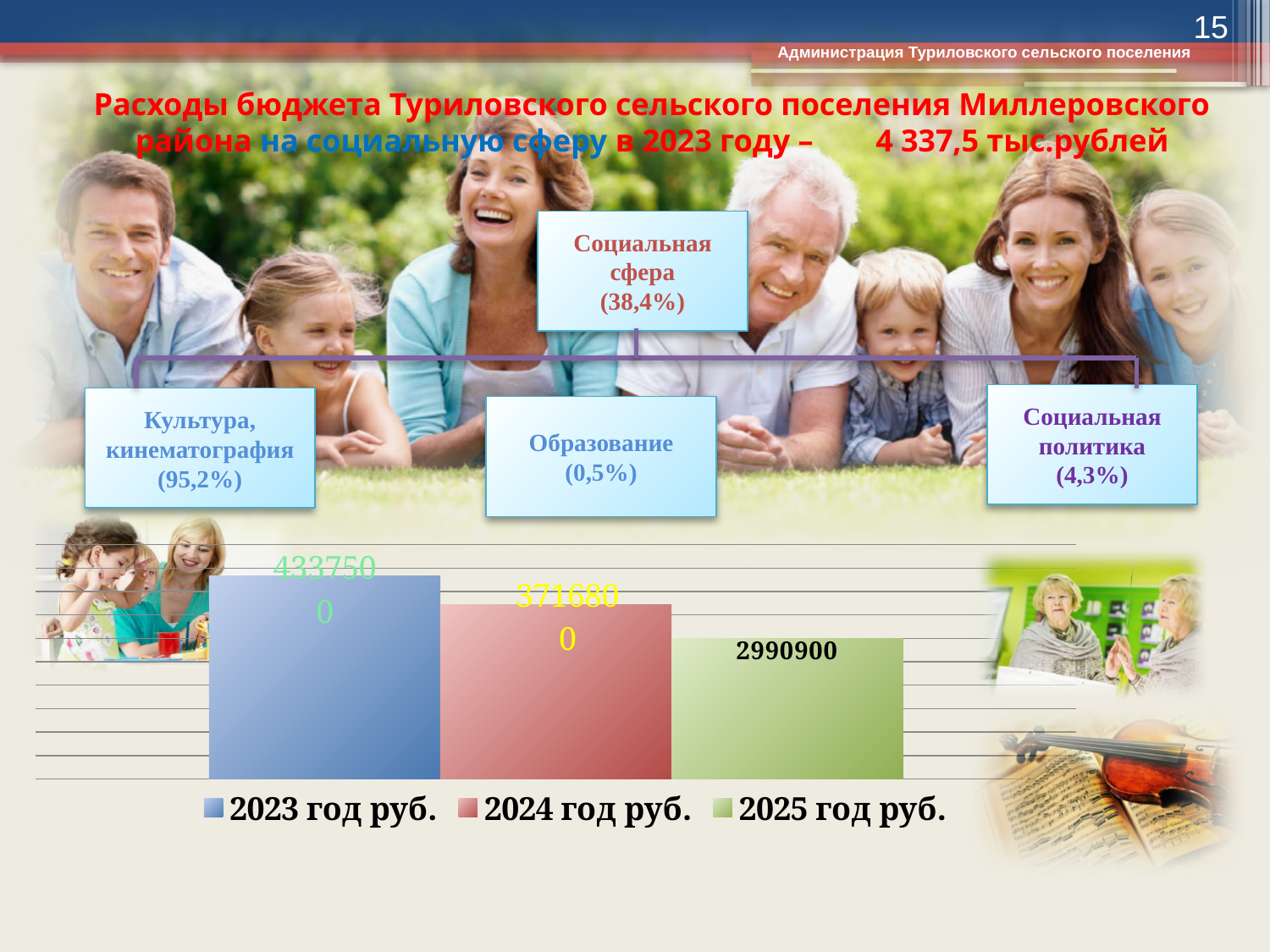
Do the values rise or fall from 2023 to 2025 in the chart? fall What is the value for 2025 год руб. in the bar chart? 2990900 What is the value for 2024 год руб. in the bar chart? 3716800 What kind of chart is shown on the slide? bar chart What is the value for 2023 год руб. in the bar chart? 4337500 Which series has the highest value in the bar chart? 2023 год руб. How many series does the chart legend list? 3 What is the difference between the values for 2023 год руб. and 2024 год руб.? 620700 What is the difference between the values for 2024 год руб. and 2025 год руб.? 725900 Which is larger, the value for 2023 год руб. or the value for 2025 год руб.? 2023 год руб. How many bars are plotted in the chart? 3 Which series has the lowest value in the bar chart? 2025 год руб.